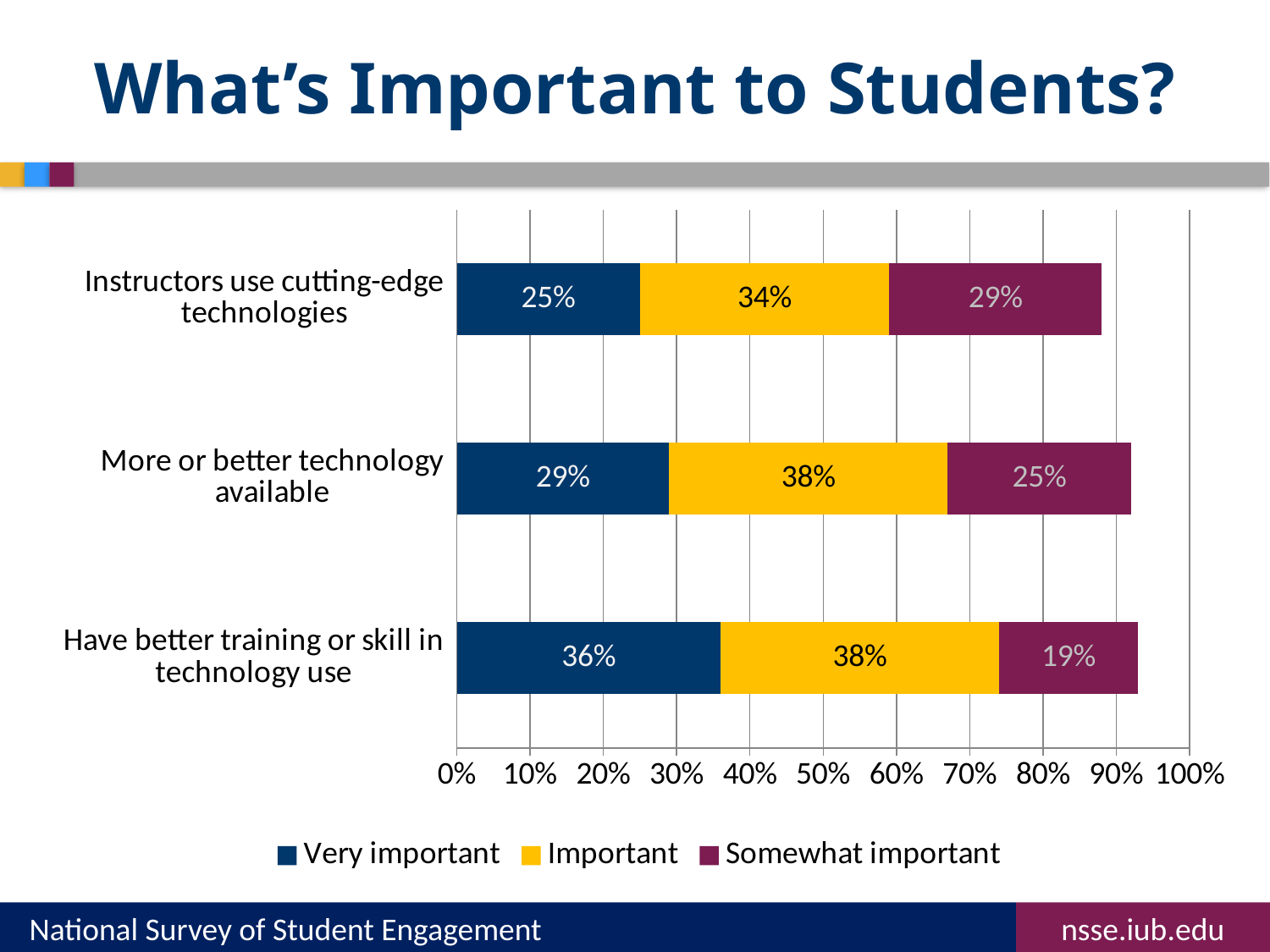
How many series does the legend list? 3 What is the total of the stacked bar for "Have better training or skill in technology use"? 93% What is the Somewhat important value for "More or better technology available"? 25% Which category has the lowest Somewhat important percentage? Have better training or skill in technology use Which category has the highest Very important percentage? Have better training or skill in technology use What percentage of students rated "Have better training or skill in technology use" as Very important? 36% What is the total of the stacked bar for "Instructors use cutting-edge technologies"? 88% How many categories are shown on the chart? 3 What is the difference between the Very important values for "Have better training or skill in technology use" and "Instructors use cutting-edge technologies"? 11% Which is larger: the Somewhat important value for "Instructors use cutting-edge technologies" or for "More or better technology available"? Instructors use cutting-edge technologies What kind of chart is shown on the slide? Stacked bar chart What is the Important value for "Instructors use cutting-edge technologies"? 34%